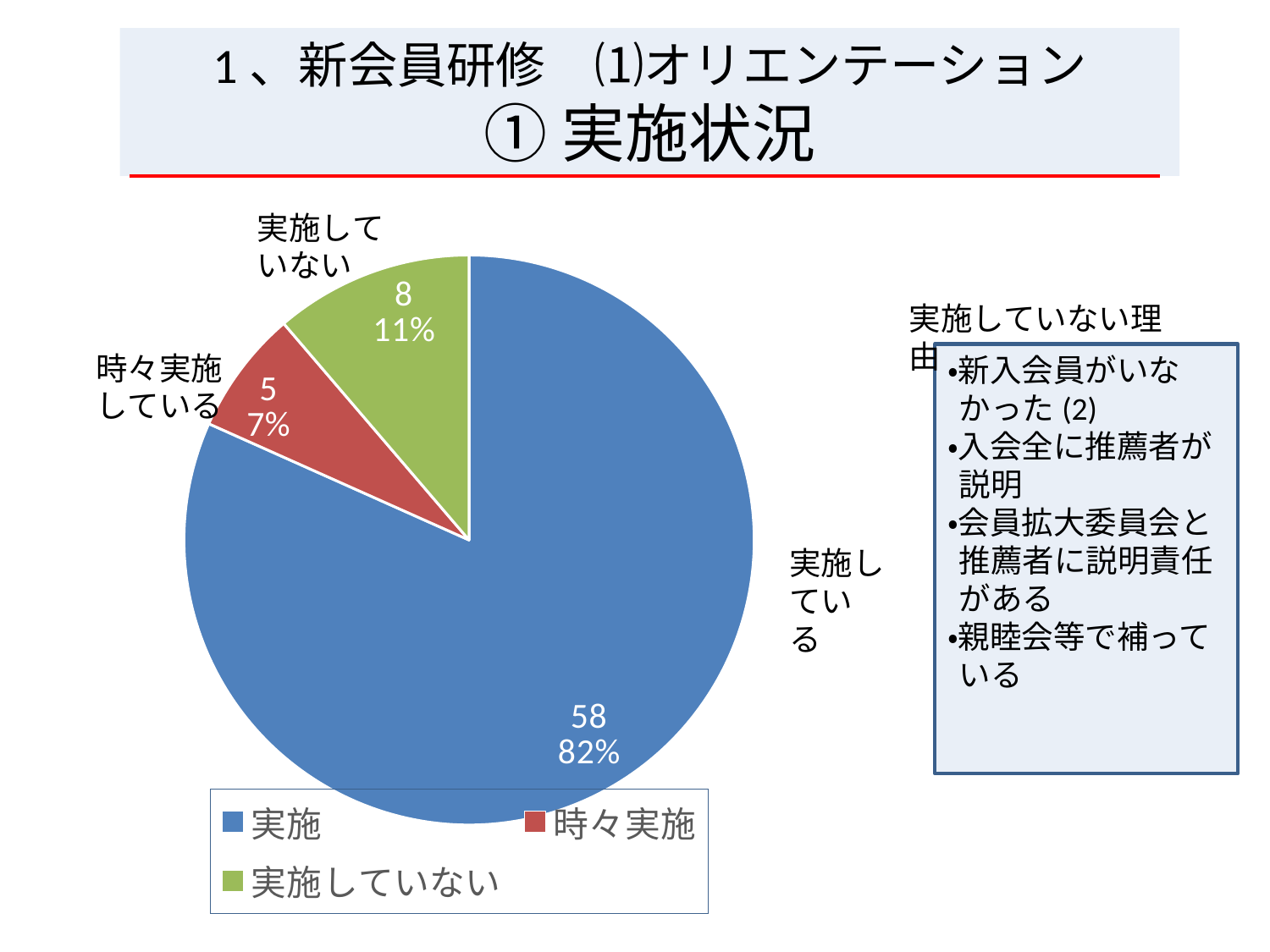
Which slice of the pie chart is the largest? 実施している Which slice of the pie chart is the smallest? 時々実施している Which colour is used for the 実施していない slice in the pie chart? green What is the count shown for the 実施している slice? 58 What is the difference between the counts for 実施している and 実施していない? 50 How many entries does the legend of the pie chart list? 3 What share of the pie does the 実施している slice represent? 82% What kind of chart is shown on the slide? pie chart What is the count shown for the 実施していない slice? 8 What share of the pie does the 実施していない slice represent? 11% How many slices does the pie chart have? 3 What is the count shown for the 時々実施している slice? 5